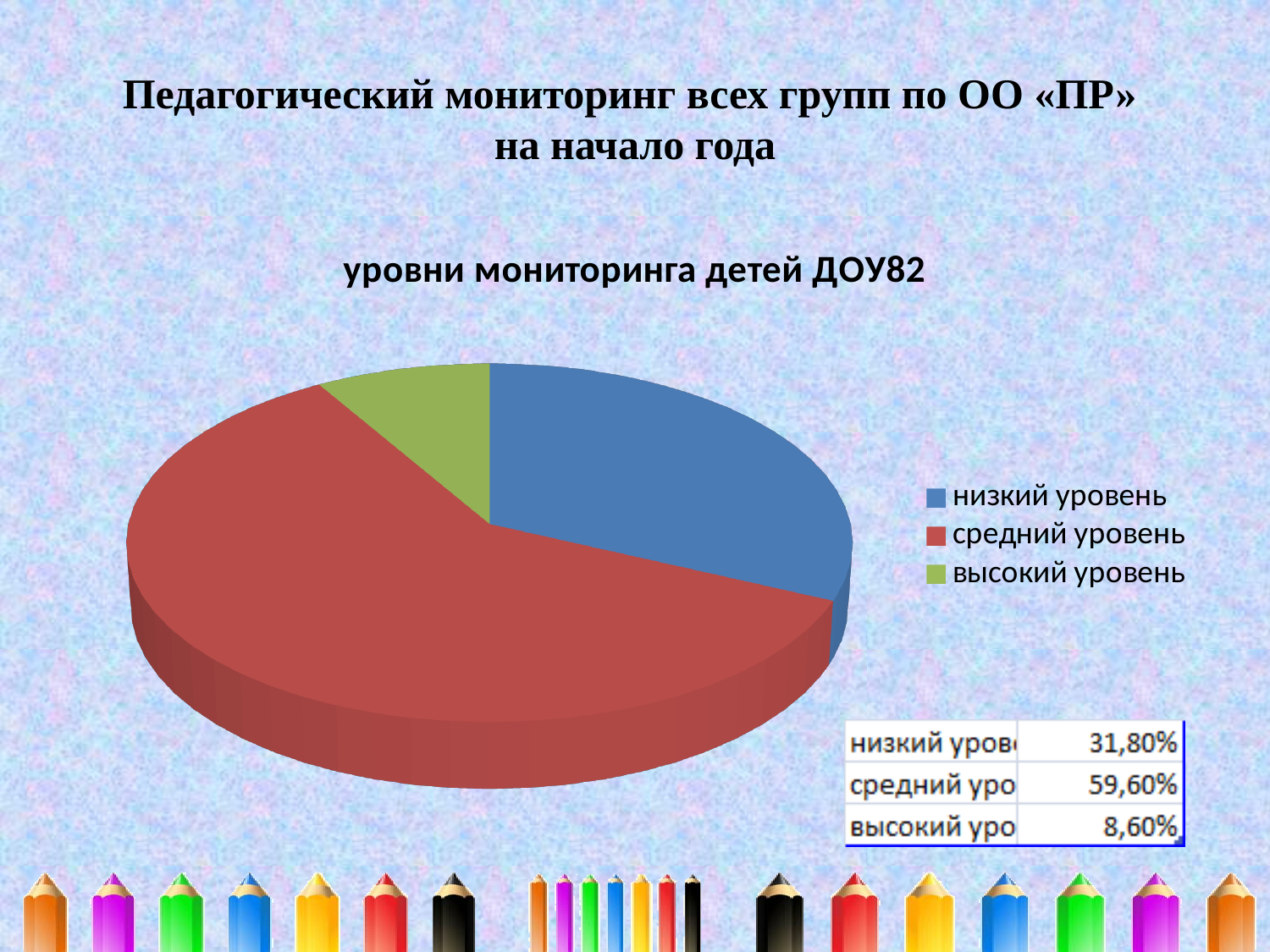
How many slices does the pie chart have? 3 What is the value for средний уровень? 59,60% Which level has the largest share of the pie? средний уровень What is the title of the chart? уровни мониторинга детей ДОУ82 Which level has the smallest share of the pie? высокий уровень What is the difference between the values for средний уровень and низкий уровень? 27,80% What is the value for высокий уровень? 8,60% What is the value for низкий уровень? 31,80% Which is larger, the value for низкий уровень or the value for высокий уровень? низкий уровень How many entries does the legend list? 3 What kind of chart is shown on the slide? pie chart Which colour represents высокий уровень in the pie chart? green